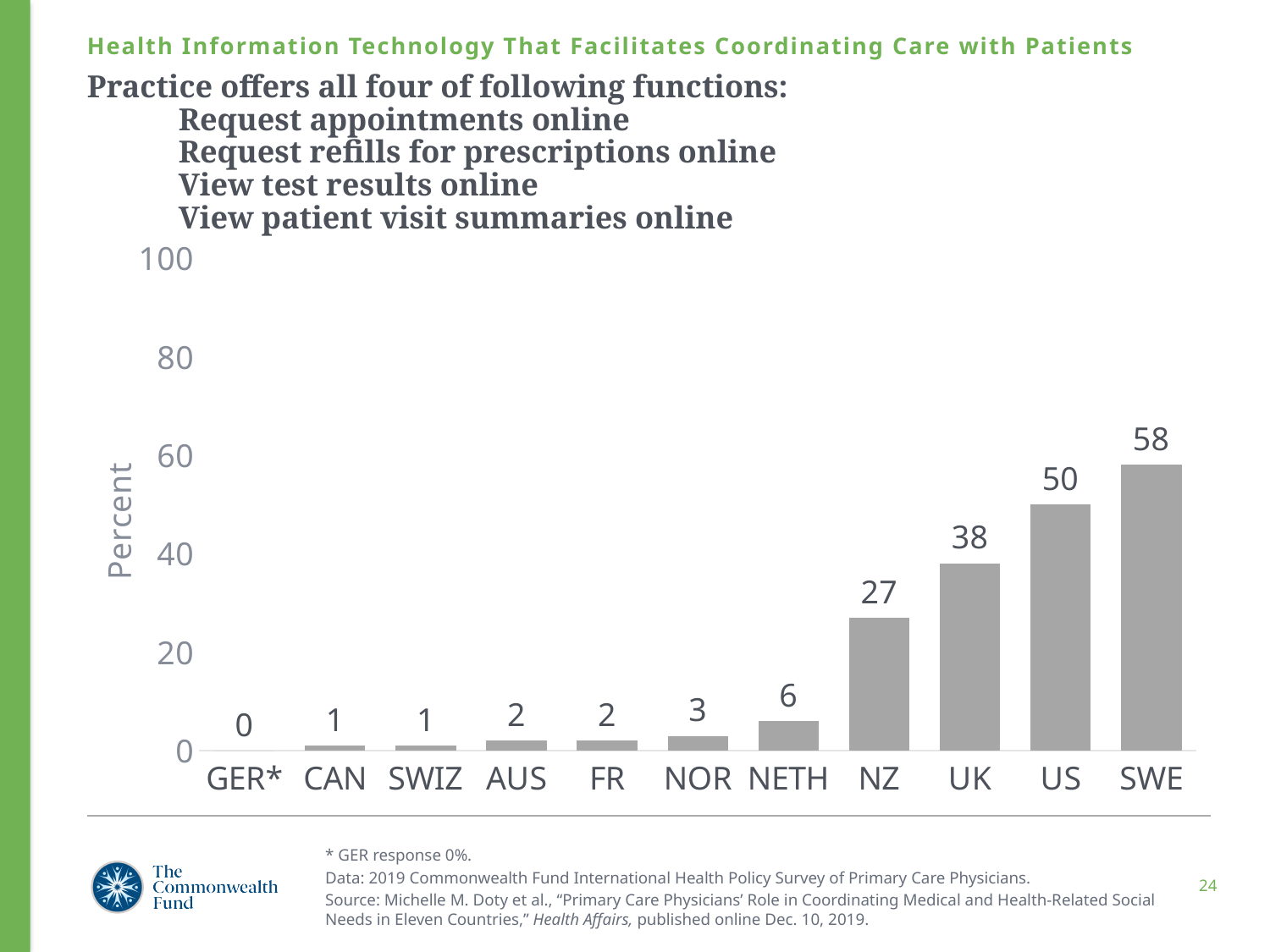
What is the difference between the values for UK and NZ? 11 What is the difference between the values for SWE and US? 8 What is the label of the y axis? Percent Which country has the lowest value? GER* Is the value for US greater or less than 40? greater Which country has the highest value? SWE What is the value for NZ? 27 What is the value for NETH? 6 How many countries are shown on the x axis? 11 What is the value for SWE? 58 What kind of chart is shown on the slide? Bar chart Which is larger, the value for UK or the value for NZ? UK